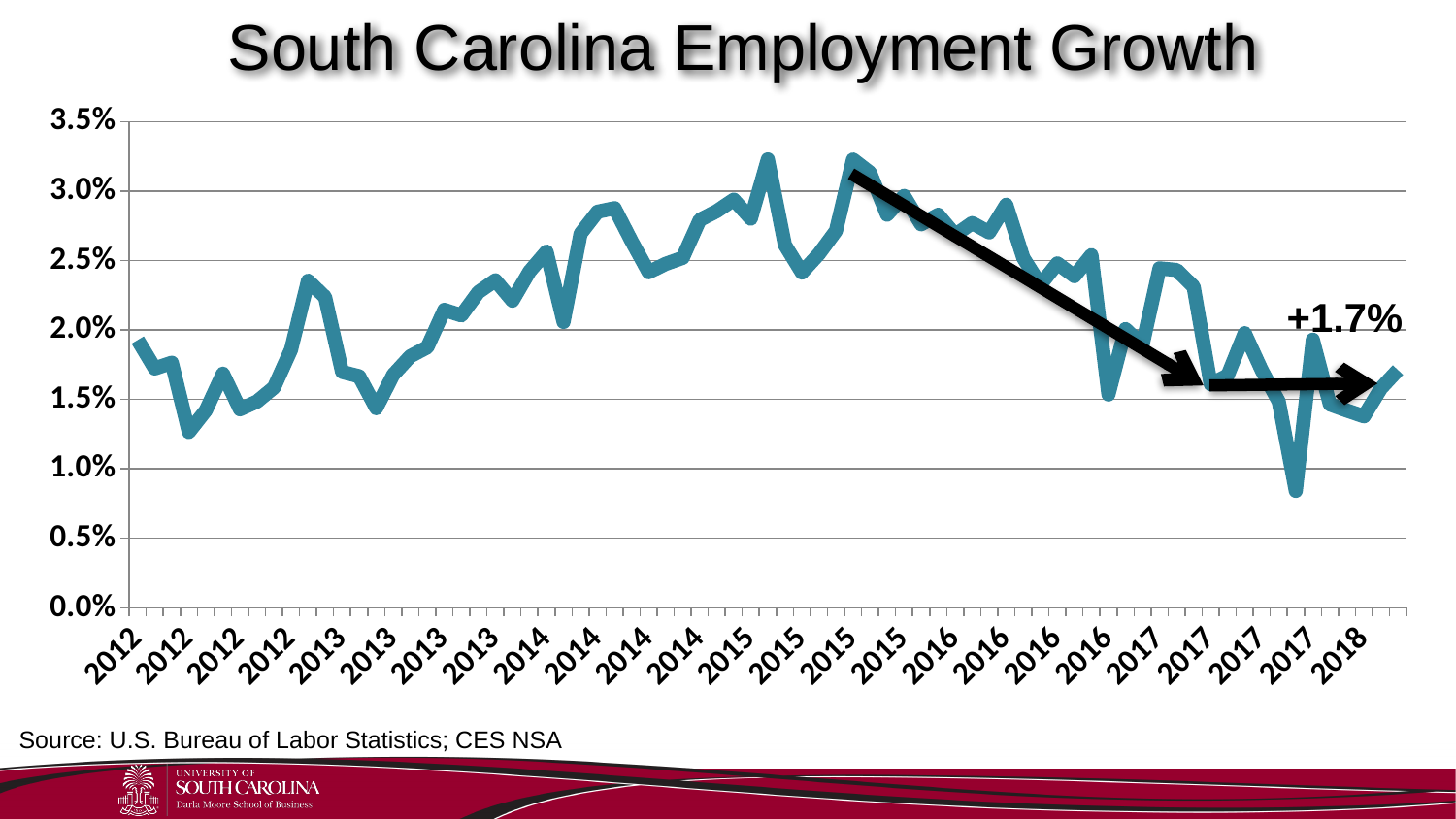
What is the highest value shown on the y axis? 3.5% What is the title of the chart? South Carolina Employment Growth Is the value at the peak in 2015 larger or smaller than the value at the end of the line in 2018? larger Which year contains the lowest point on the line? 2017 Does the line generally rise or fall between 2013 and 2015? rise What growth figure is annotated at the right end of the line? +1.7% Is the first value plotted in 2012 greater or less than 1.5%? greater How many data series are plotted on the chart? 1 Is the highest point on the line greater or less than 3.0%? greater What kind of chart is shown on the slide? Line chart Is the lowest point on the line, in late 2017, greater or less than 1.0%? less Does the line generally rise or fall between 2015 and 2017? fall